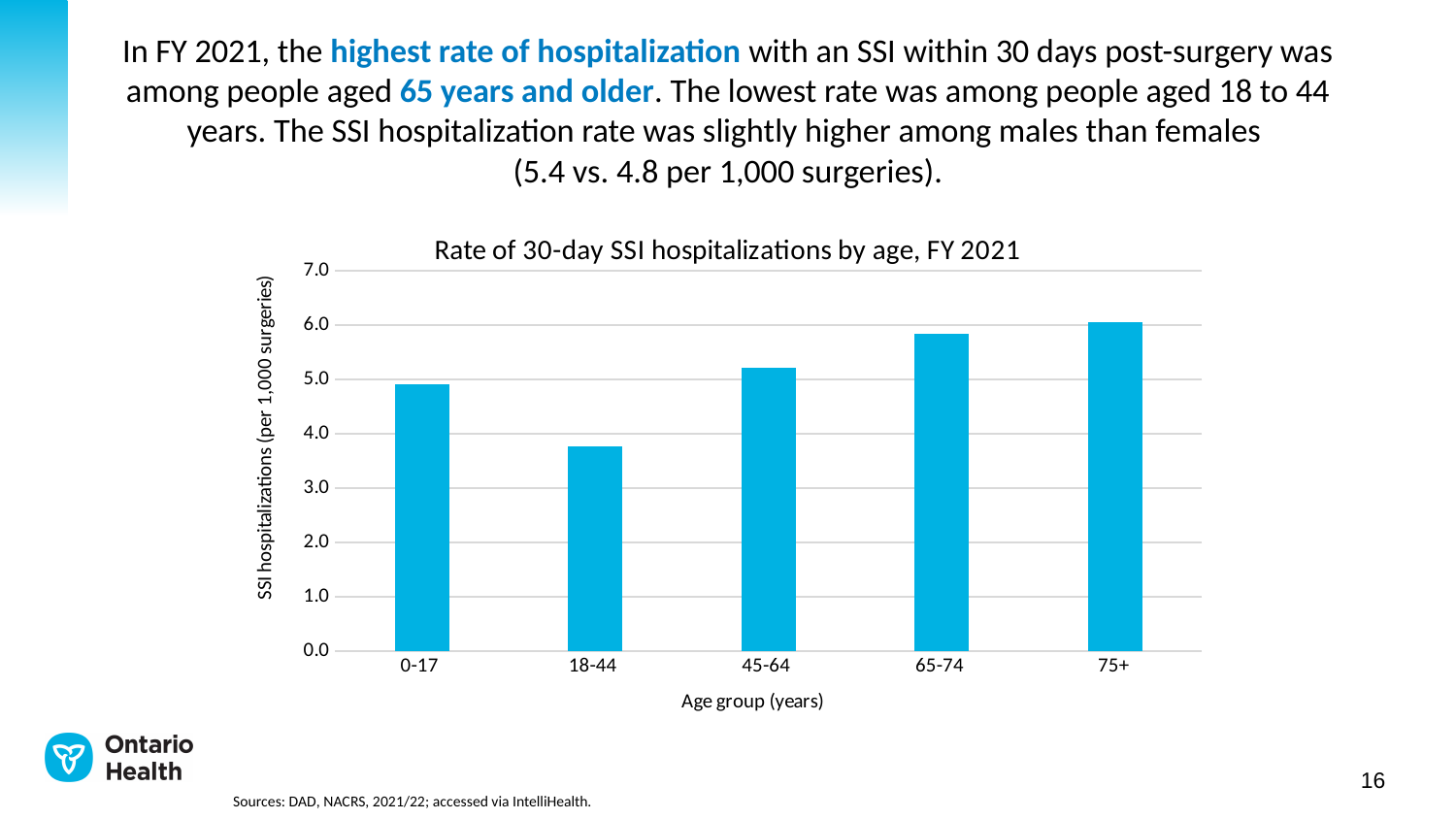
Is the value for the 65-74 age group greater or less than 5.0? greater Which has a higher SSI hospitalization rate, the 0-17 age group or the 45-64 age group? 45-64 What is the label of the y axis of the chart? SSI hospitalizations (per 1,000 surgeries) Is the value for the 18-44 age group greater or less than 4.0? less Do the values rise or fall along the x axis from the 18-44 age group to the 75+ age group? rise Which age group has the lowest rate of 30-day SSI hospitalizations? 18-44 How many age groups are shown on the x axis of the chart? 5 What is the title of the chart? Rate of 30-day SSI hospitalizations by age, FY 2021 Which age group has the highest rate of 30-day SSI hospitalizations? 75+ What kind of chart is shown on the slide? bar chart